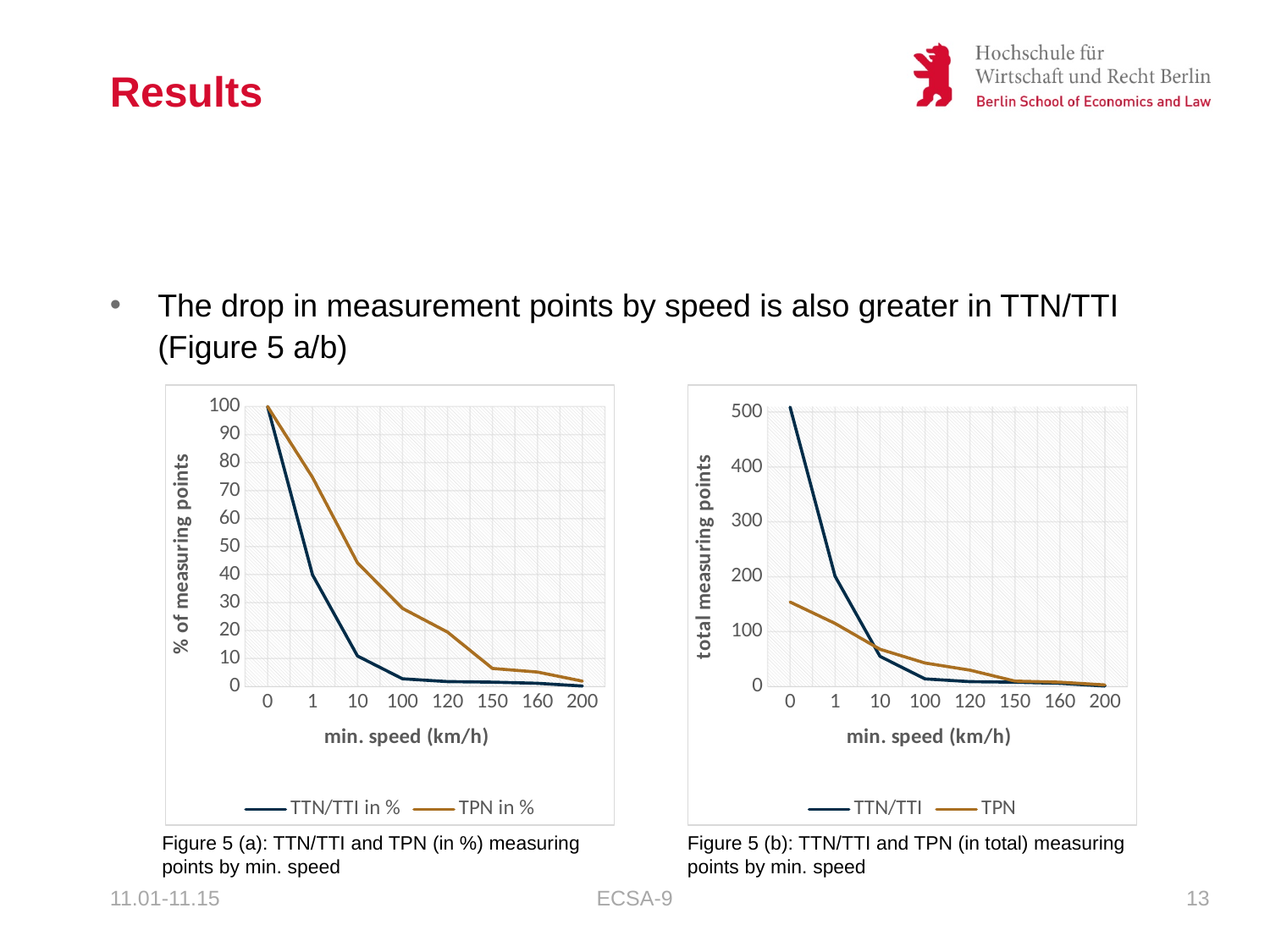
In Figure 5 (b), at a min. speed of 100 km/h, which series has the larger value, TTN/TTI or TPN? TPN In Figure 5 (a), how many min. speed categories are shown on the x axis? 8 In Figure 5 (a), is the value of TTN/TTI in % at 1 km/h greater or less than 50? less In Figure 5 (b), what is the label of the y axis? total measuring points In Figure 5 (a), how many series does the legend list? 2 In Figure 5 (a), at a min. speed of 1 km/h, which series has the larger value, TTN/TTI in % or TPN in %? TPN in % In Figure 5 (a), do the values rise or fall as min. speed increases? fall In Figure 5 (a), what is the value of TTN/TTI in % at a min. speed of 0 km/h? 100 In Figure 5 (a), what kind of chart is shown? line chart In Figure 5 (a), is the value of TPN in % at 1 km/h greater or less than 60? greater In Figure 5 (b), is the value of TTN/TTI at 0 km/h greater or less than 400? greater